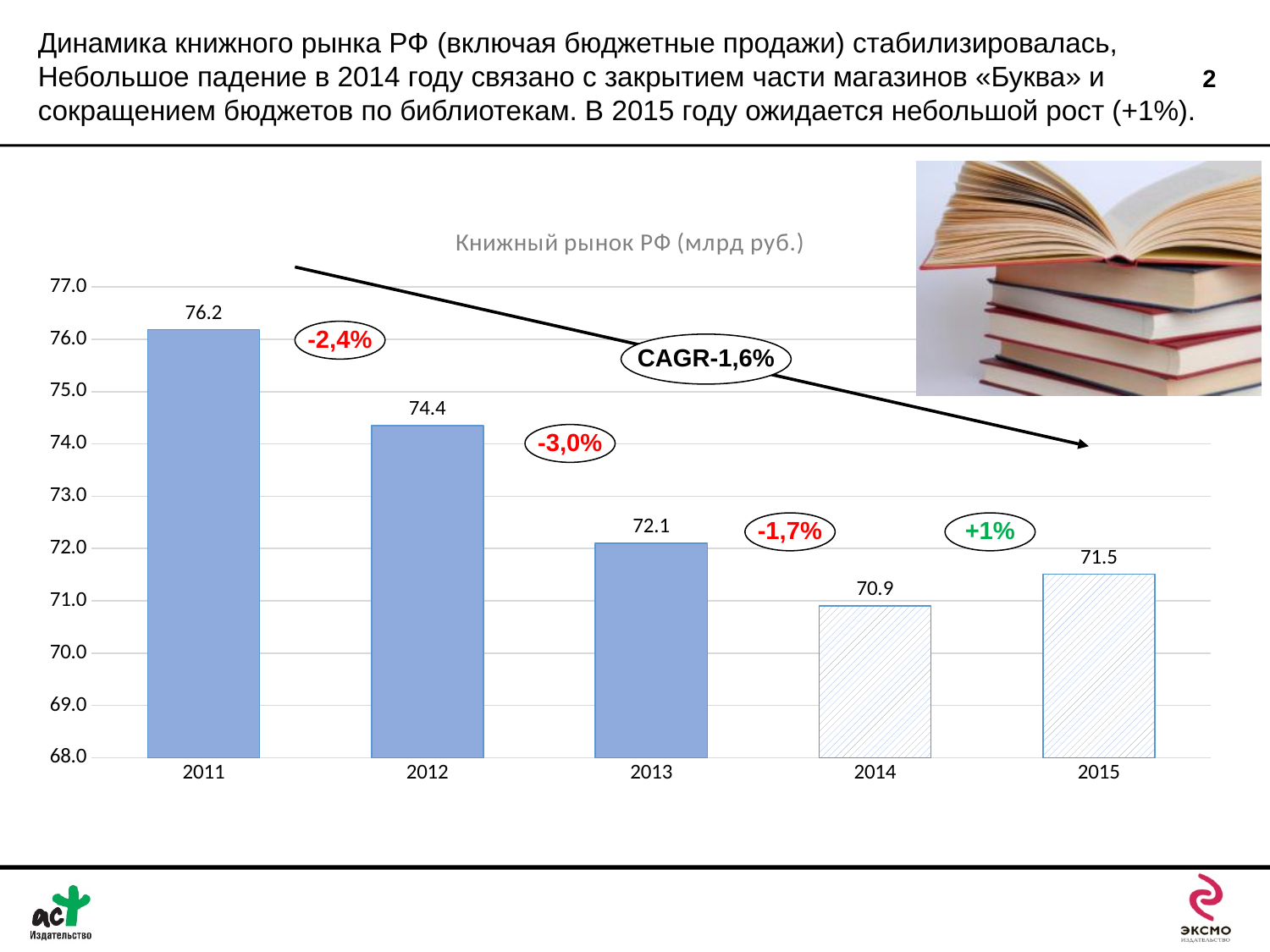
What is the value for 2011? 76.2 What is the title of the chart? Книжный рынок РФ (млрд руб.) Which is larger, the value for 2012 or the value for 2013? 2012 How many years are shown on the x axis? 5 Which year has the lowest value? 2014 What kind of chart is this? bar chart Is the value for 2013 greater or less than 73.0? less What is the difference between the values for 2015 and 2014? 0.6 What is the value for 2015? 71.5 What is the value for 2014? 70.9 What is the difference between the values for 2011 and 2013? 4.1 Which year has the highest value? 2011